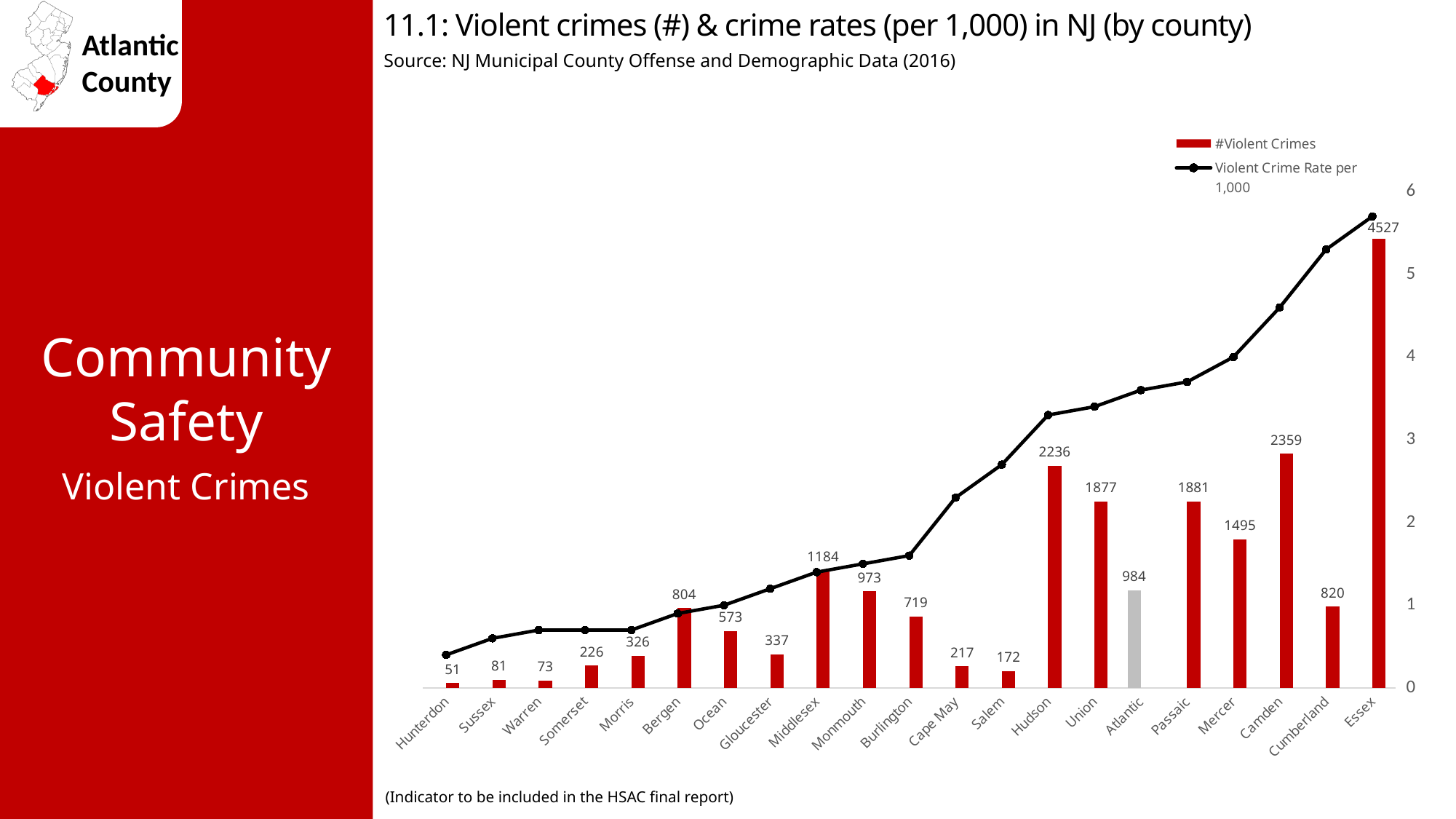
Does the violent crime rate per 1,000 line generally rise or fall from Hunterdon to Essex? Rise How many violent crimes are shown for Cumberland county? 820 What kind of chart is shown on the slide? Bar and line chart Is the violent crime rate per 1,000 for Essex greater or less than 5? greater Is the violent crime rate per 1,000 for Hunterdon greater or less than 1? less How many counties are shown on the x axis of the chart? 21 How many violent crimes are shown for Atlantic county? 984 Which county has the highest number of violent crimes? Essex Which county has more violent crimes, Middlesex or Monmouth? Middlesex Which county has the lowest number of violent crimes? Hunterdon How many series does the chart legend list? 2 What is the difference in the number of violent crimes between Camden and Hudson? 123